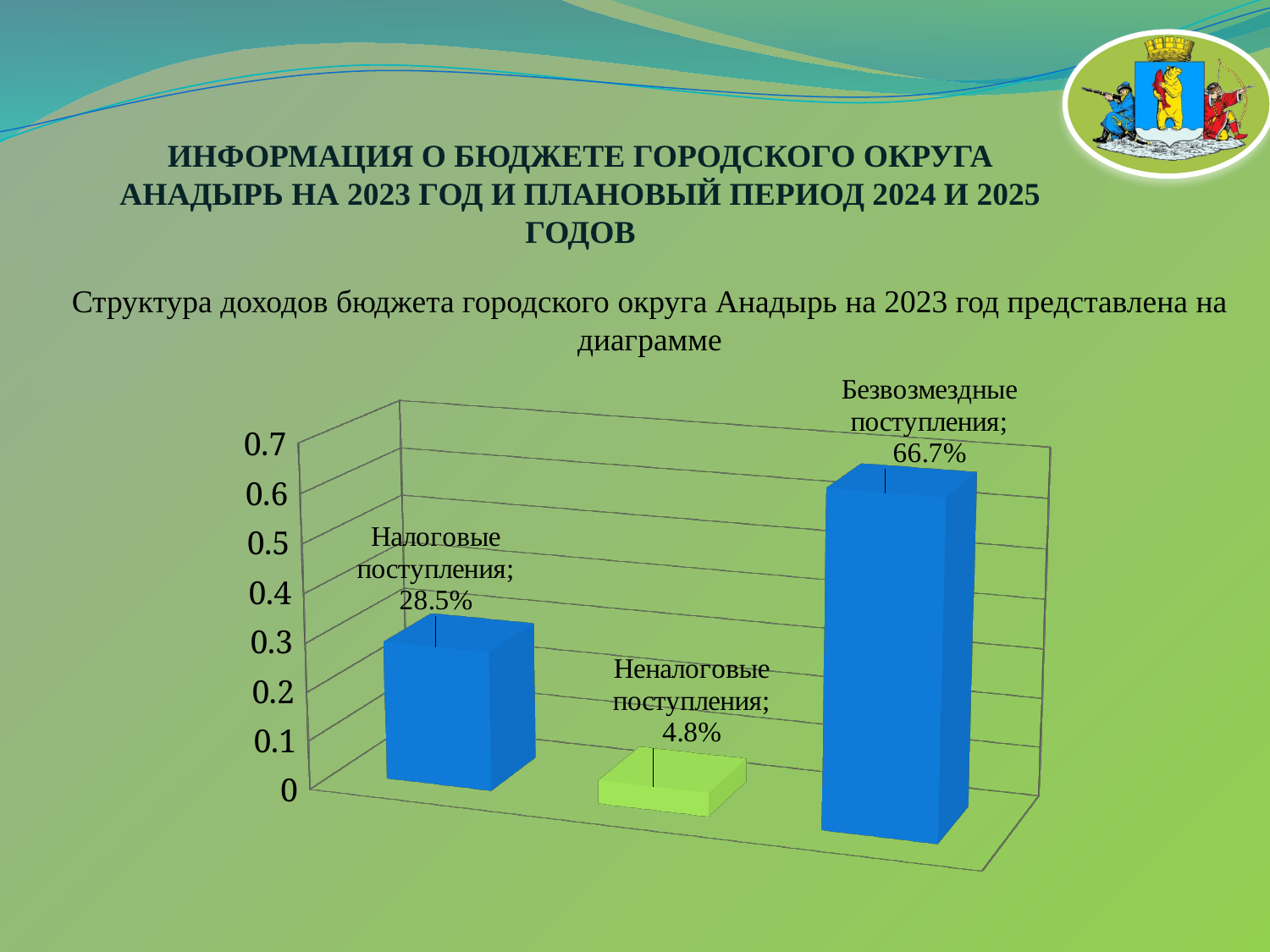
What is the highest value shown on the vertical axis? 0.7 What kind of chart is shown on the slide? bar chart Is the value for Безвозмездные поступления greater or less than 0.5? greater How many categories are shown in the chart? 3 Which is larger, Налоговые поступления or Неналоговые поступления? Налоговые поступления Which category has the highest value? Безвозмездные поступления What is the value for Налоговые поступления? 28.5% Which category has the lowest value? Неналоговые поступления What is the difference between Безвозмездные поступления and Налоговые поступления? 38.2% What is the difference between Налоговые поступления and Неналоговые поступления? 23.7% What is the value for Безвозмездные поступления? 66.7% What is the value for Неналоговые поступления? 4.8%